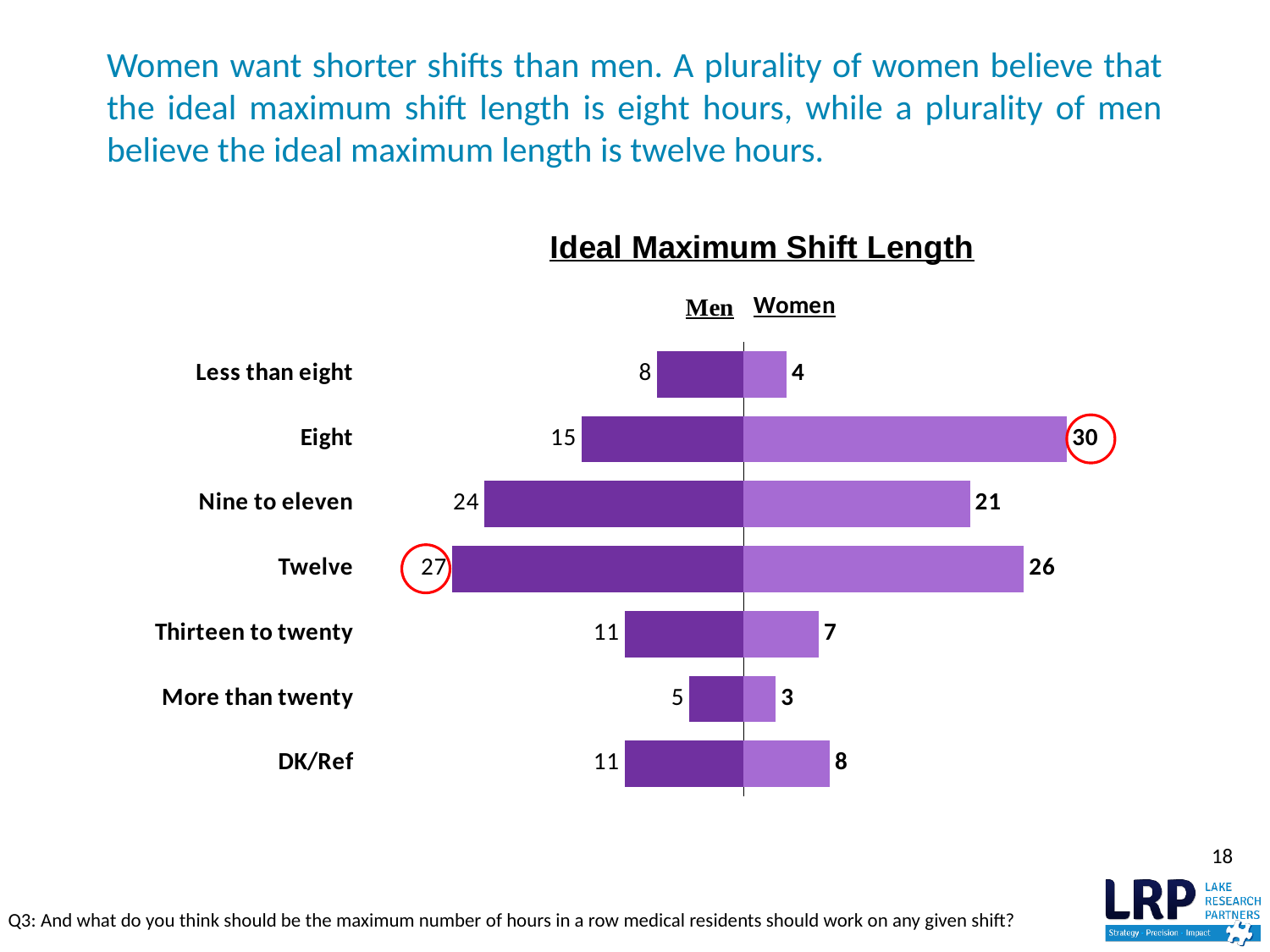
What is the value for Men in the Twelve category? 27 Which category has the lowest value for Men? More than twenty What is the value for Women in the Nine to eleven category? 21 What is the value for Men in the DK/Ref category? 11 Which category has the highest value for Women? Eight What kind of chart is this? Bar chart Which is larger for Nine to eleven, the Men value or the Women value? Men What is the title of the chart? Ideal Maximum Shift Length What is the value for Women in the Eight category? 30 How many categories are shown on the chart? 7 How many series does the chart show? 2 What is the difference between the Men and Women values for Eight? 15